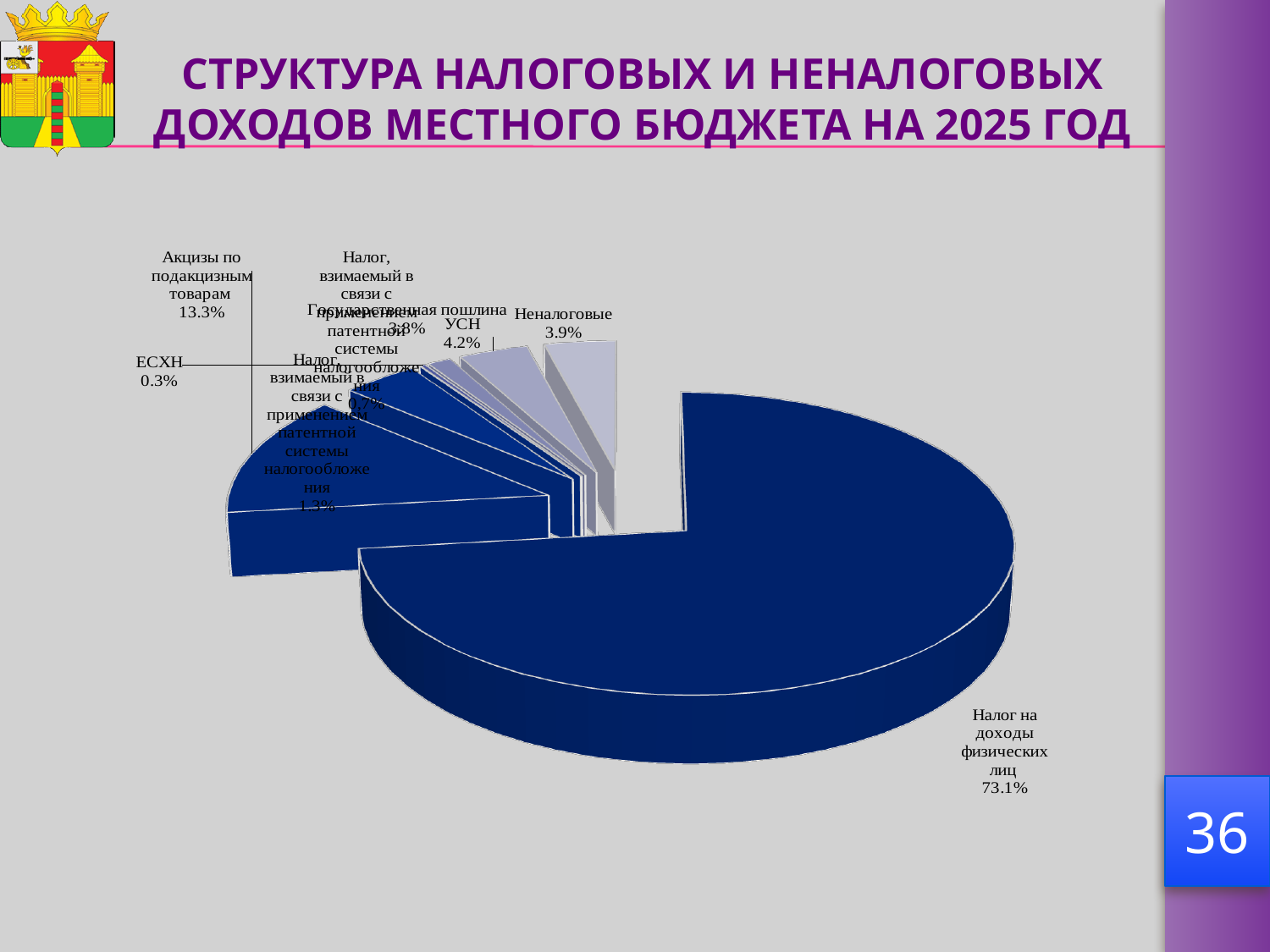
Which revenue source has the largest share of the pie? Налог на доходы физических лиц What share of the local budget's tax and non-tax revenues for 2025 comes from Налог на доходы физических лиц? 73.1% What percentage is shown for ЕСХН? 0.3% By how many percentage points does the share of Налог на доходы физических лиц exceed the share of Акцизы по подакцизным товарам? 59.8 What percentage is shown for Неналоговые revenues? 3.9% What percentage is shown for Акцизы по подакцизным товарам? 13.3% What percentage is shown for УСН? 4.2% What kind of chart is shown on the slide? pie chart Which has a larger share: УСН or Неналоговые? УСН Which has a larger share: Акцизы по подакцизным товарам or УСН? Акцизы по подакцизным товарам What is the title of the slide containing the chart? СТРУКТУРА НАЛОГОВЫХ И НЕНАЛОГОВЫХ ДОХОДОВ МЕСТНОГО БЮДЖЕТА НА 2025 ГОД